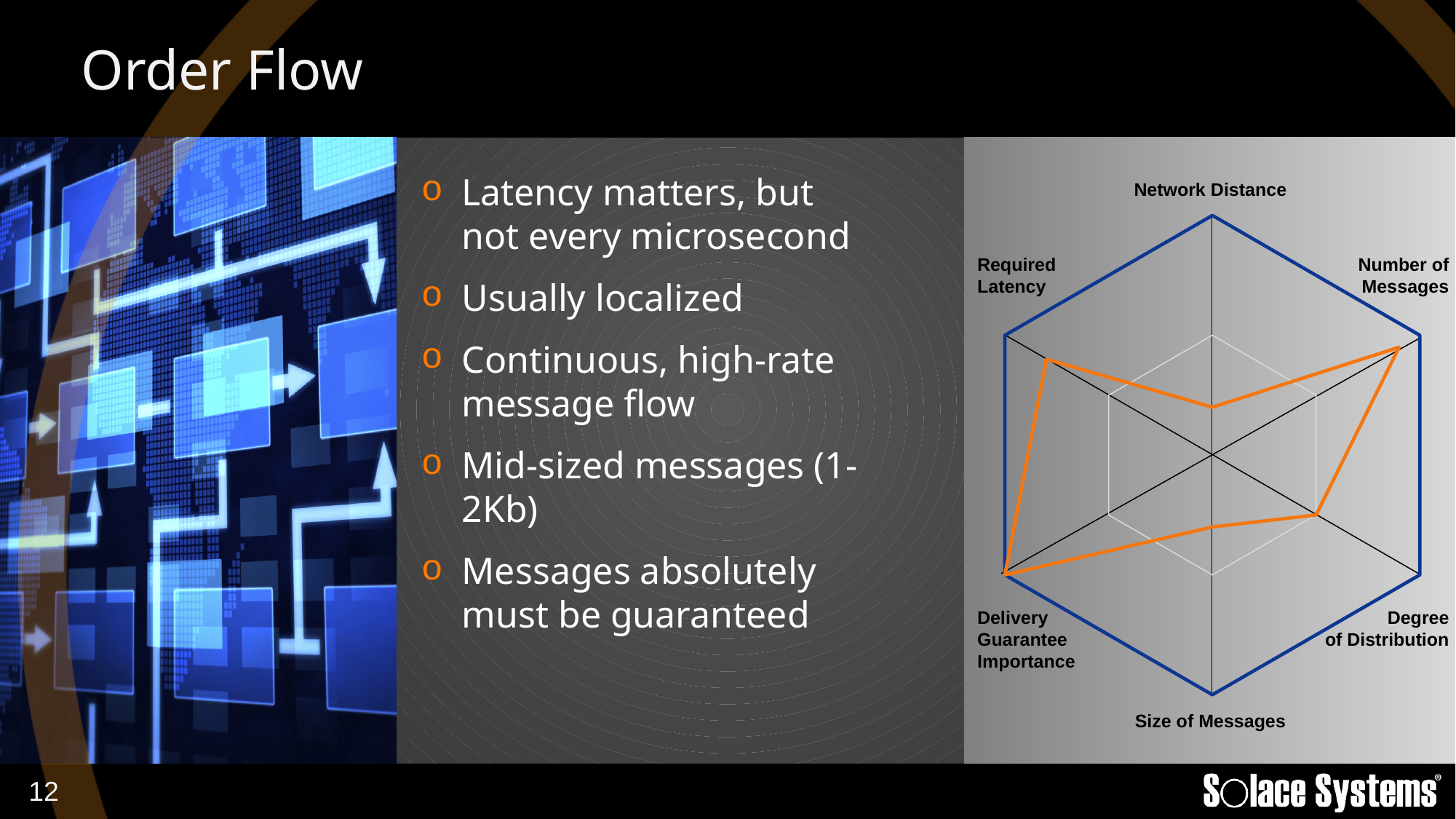
Which category label appears at the bottom of the radar chart? Size of Messages Which is larger on the radar chart: the value for Size of Messages or the value for Number of Messages? Number of Messages How many axes (categories) does the radar chart have? 6 Which category has the lowest value on the radar chart? Network Distance Which is larger on the radar chart: the value for Degree of Distribution or the value for Size of Messages? Degree of Distribution Which is larger on the radar chart: the value for Network Distance or the value for Delivery Guarantee Importance? Delivery Guarantee Importance What kind of chart is shown on the right of the slide? Radar chart What colour is the plotted data line on the radar chart? Orange Which category label appears at the top of the radar chart? Network Distance